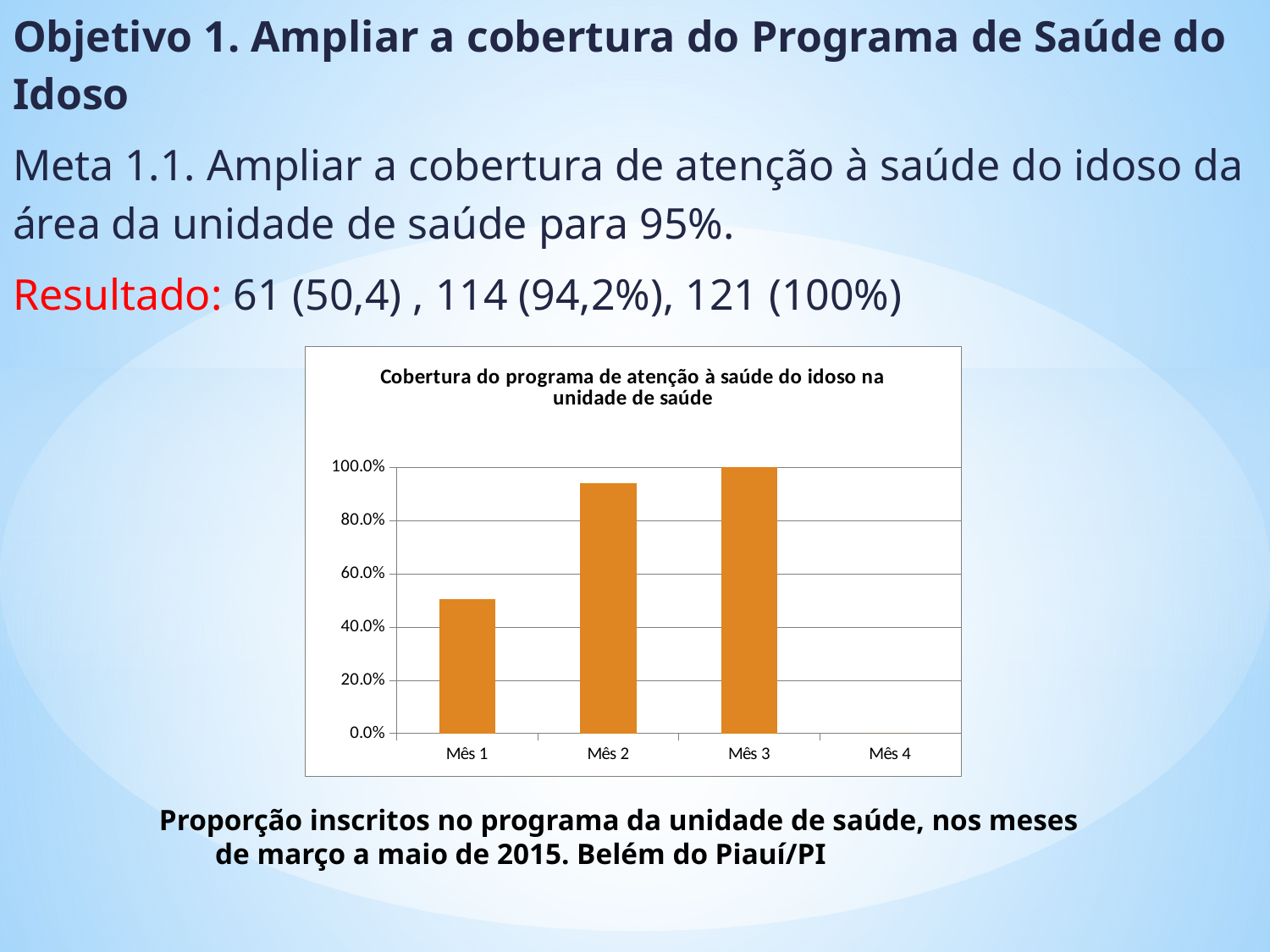
How many category labels are shown on the x axis? 4 What is the title of the chart? Cobertura do programa de atenção à saúde do idoso na unidade de saúde Is the value for Mês 1 greater or less than 40.0%? greater What kind of chart is shown on the slide? bar chart What colour are the bars in the chart? orange What is the value for Mês 3? 100.0% Do the values rise or fall from Mês 1 to Mês 3? rise Which month has the shortest bar among the plotted bars? Mês 1 Is the value for Mês 2 greater or less than 80.0%? greater Which month has the tallest bar? Mês 3 Which is larger, the value for Mês 1 or the value for Mês 2? Mês 2 Is the value for Mês 1 greater or less than 60.0%? less